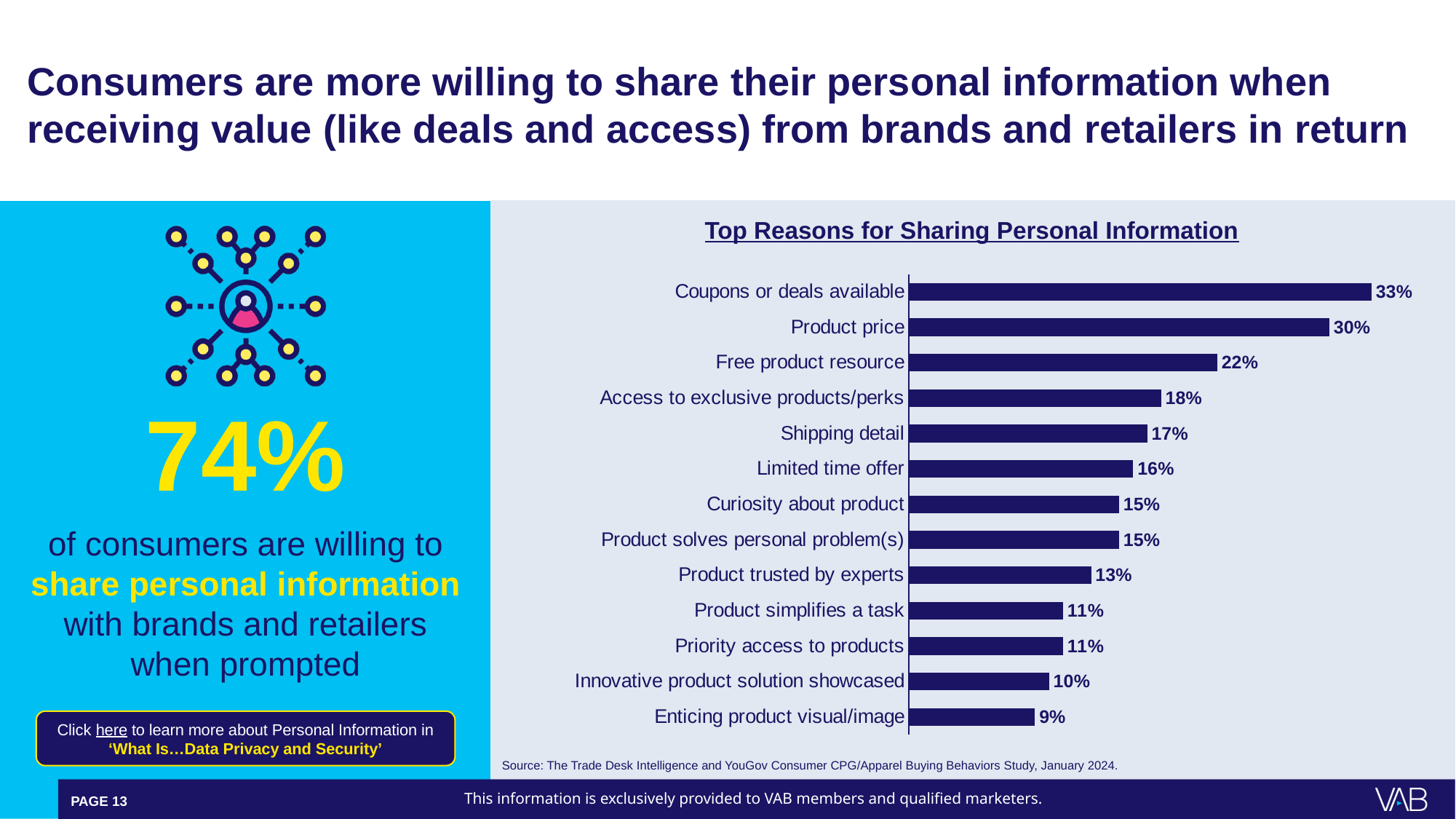
Which is larger, Product trusted by experts or Product simplifies a task? Product trusted by experts What is the difference between Coupons or deals available and Enticing product visual/image? 24% Which reason has the lowest value? Enticing product visual/image What is the difference between Product price and Free product resource? 8% What kind of chart is shown? Bar chart What is the title of the chart? Top Reasons for Sharing Personal Information What is the value for Shipping detail? 17% How many reasons are shown in the chart? 13 What is the value for Coupons or deals available? 33% Which reason has the highest value? Coupons or deals available Which is larger, Access to exclusive products/perks or Limited time offer? Access to exclusive products/perks What is the value for Innovative product solution showcased? 10%